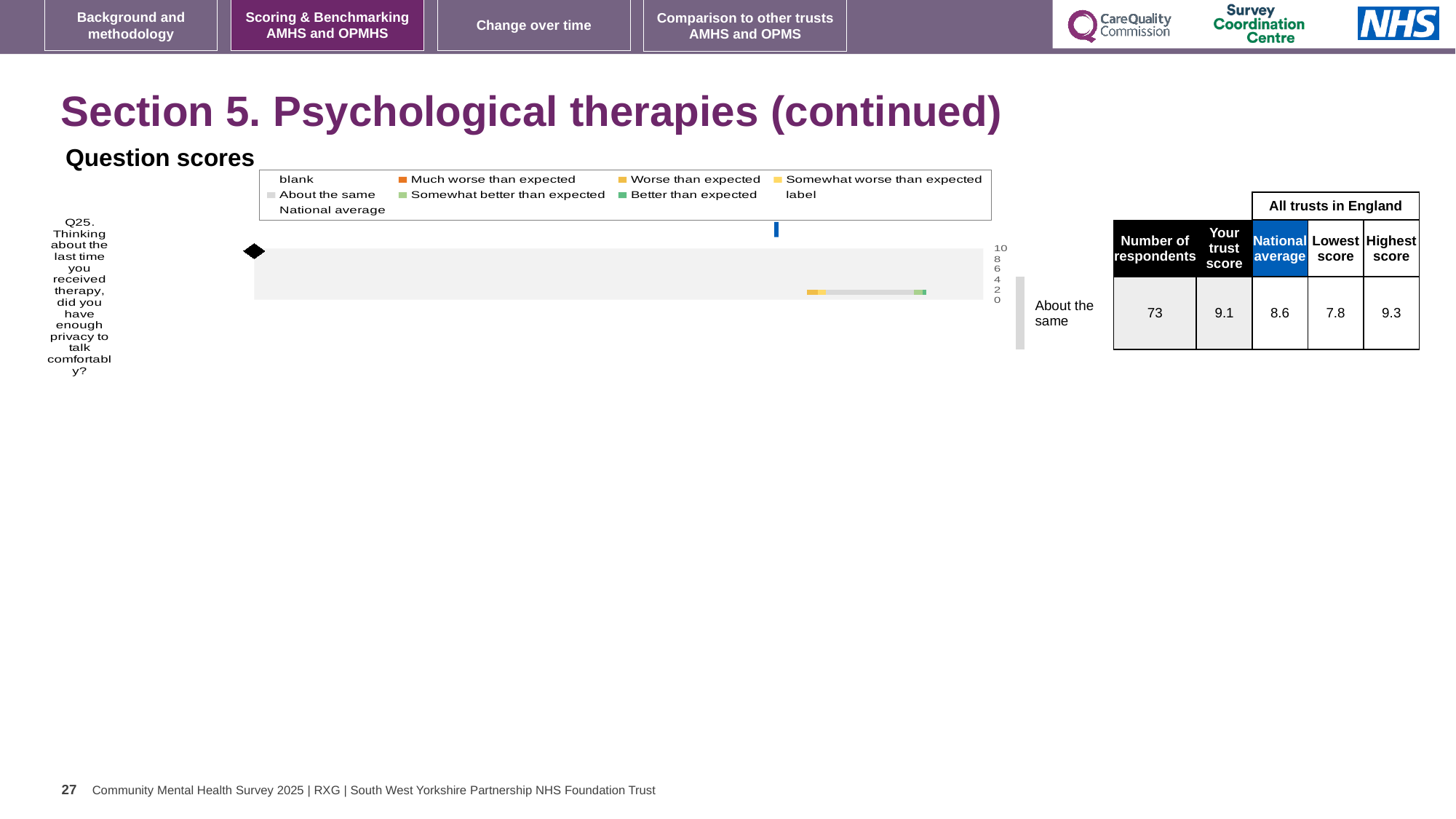
How many questions (categories) are plotted in the Question scores chart? 1 What is the highest tick value shown on the axis of the Question scores chart? 10 What benchmark rating is shown for Q25 in the Question scores chart? About the same In the table beside the Question scores chart, what is the National average for Q25? 8.6 Which legend entry in the Question scores chart is shown in grey? About the same In the table beside the Question scores chart, what is the difference between Your trust score and the National average for Q25? 0.5 In the table beside the Question scores chart, what is 'Your trust score' for Q25? 9.1 In the table beside the Question scores chart, what is the difference between the Highest score and the Lowest score for Q25? 1.5 In the table beside the Question scores chart, which is larger for Q25: Your trust score or the National average? Your trust score What kind of chart is shown under 'Question scores'? bar chart How many entries does the legend of the Question scores chart list? 9 In the table beside the Question scores chart, what is the number of respondents for Q25? 73